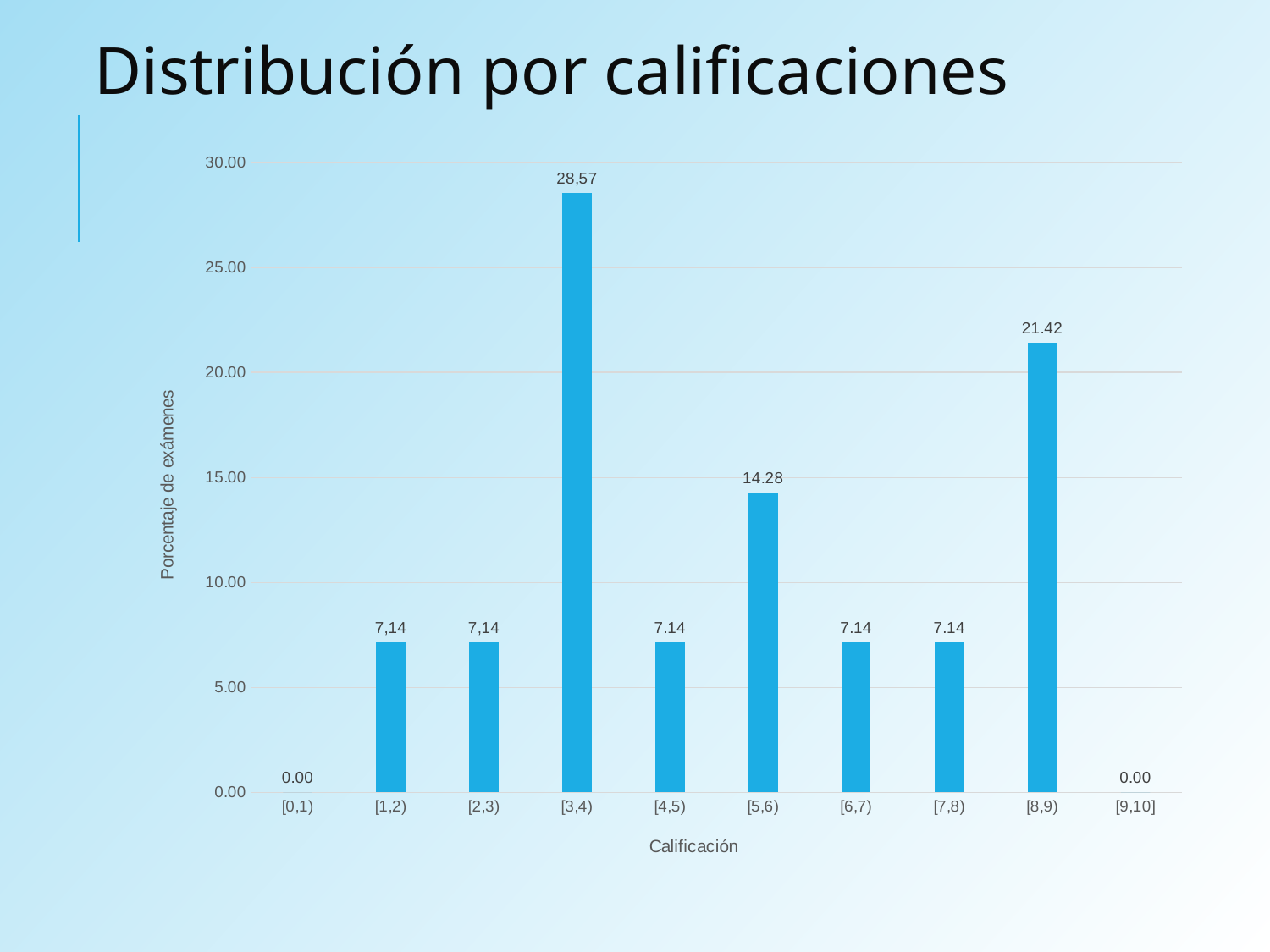
What is the value for the [8,9) category? 21.42 What kind of chart is shown on the slide? bar chart Which is larger, the value for [5,6) or the value for [8,9)? [8,9) What is the value for the [1,2) category? 7,14 Which category has the highest value? [3,4) What is the difference between the values for [3,4) and [8,9)? 7.15 How many categories are shown on the x axis? 10 What is the value for the [5,6) category? 14.28 What is the label of the y axis? Porcentaje de exámenes What is the value for the [9,10] category? 0.00 What is the value for the [3,4) category? 28,57 Is the value for [3,4) greater or less than 25.00? greater